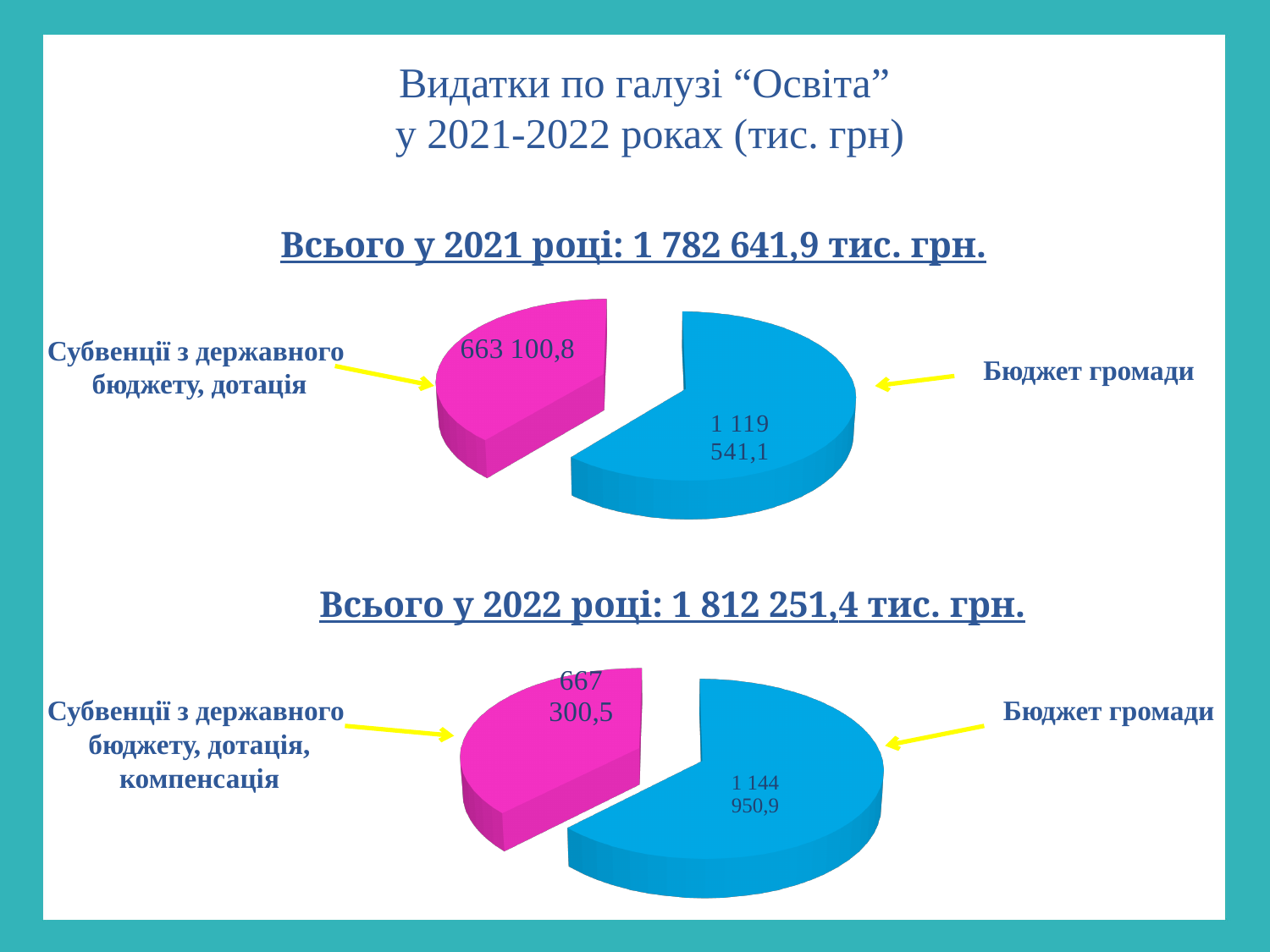
In the 2022 pie chart, what is the difference between Бюджет громади and Субвенції з державного бюджету, дотація, компенсація? 477 650,4 In the 2021 pie chart, what share of the total does Бюджет громади represent? 62.8% What type of chart is used on this slide for the 2021 and 2022 data? Pie chart In the 2022 pie chart, what is the value for Бюджет громади? 1 144 950,9 In the 2022 pie chart, what is the value for Субвенції з державного бюджету, дотація, компенсація? 667 300,5 Which is larger: Бюджет громади in the 2021 chart or Бюджет громади in the 2022 chart? Бюджет громади in 2022 In the 2021 pie chart, which category has the largest slice? Бюджет громади In the 2022 pie chart, which category has the smallest slice? Субвенції з державного бюджету, дотація, компенсація In the 2021 pie chart, what is the difference between Бюджет громади and Субвенції з державного бюджету, дотація? 456 440,3 In the 2021 pie chart, what is the value for Субвенції з державного бюджету, дотація? 663 100,8 How many slices does the 2022 pie chart have? 2 In the 2021 pie chart, what is the value for Бюджет громади? 1 119 541,1